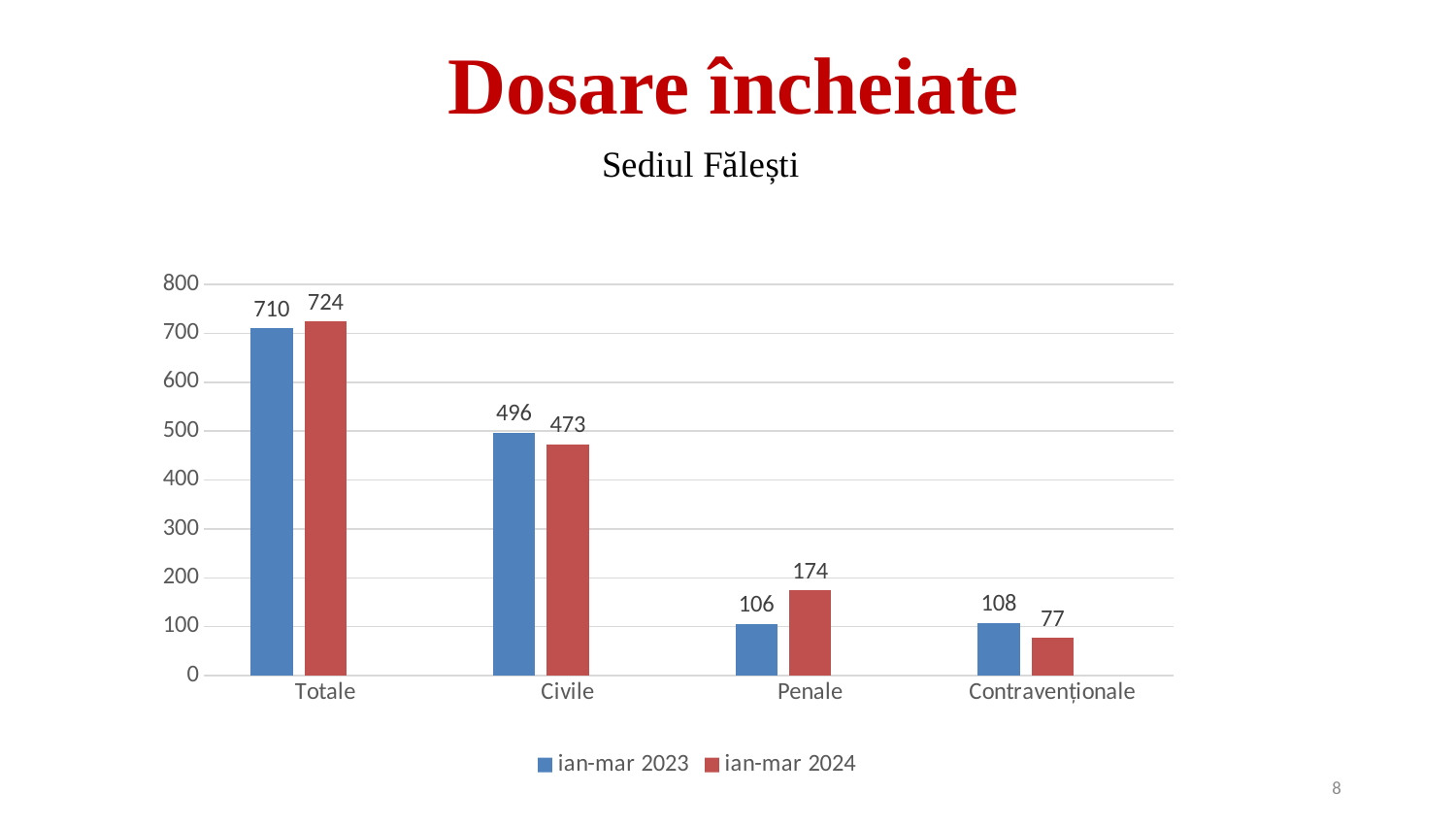
What kind of chart is shown on the slide? bar chart How many categories are shown on the x axis? 4 Which category has the highest value in the ian-mar 2023 series? Totale What is the value for Civile in the ian-mar 2023 series? 496 Which category has the lowest value in the ian-mar 2024 series? Contravenționale What is the value for Penale in the ian-mar 2024 series? 174 What is the difference between the ian-mar 2023 and ian-mar 2024 values for Civile? 23 What is the value for Totale in the ian-mar 2024 series? 724 What is the difference between the ian-mar 2024 and ian-mar 2023 values for Penale? 68 How many series does the legend list? 2 Which is larger for Contravenționale: the ian-mar 2023 value or the ian-mar 2024 value? ian-mar 2023 What is the value for Contravenționale in the ian-mar 2023 series? 108